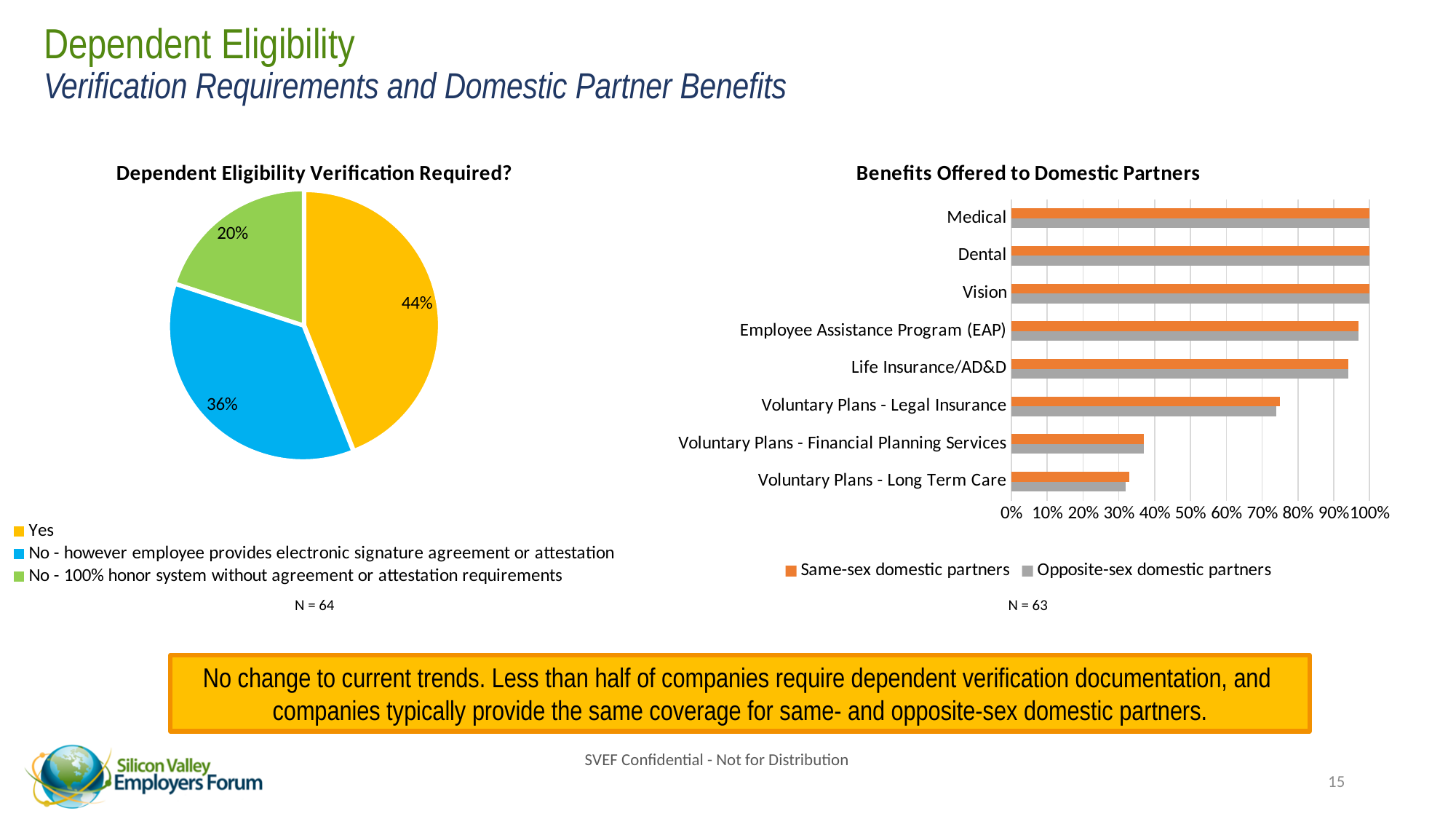
In the 'Benefits Offered to Domestic Partners' chart, is the value for 'Voluntary Plans - Long Term Care' for same-sex domestic partners greater or less than 50%? less In the 'Benefits Offered to Domestic Partners' chart, which is larger for same-sex domestic partners: 'Life Insurance/AD&D' or 'Voluntary Plans - Legal Insurance'? Life Insurance/AD&D What kind of chart is 'Benefits Offered to Domestic Partners'? Bar chart In the 'Dependent Eligibility Verification Required?' chart, what share answered 'No - however employee provides electronic signature agreement or attestation'? 36% In the 'Dependent Eligibility Verification Required?' chart, what share of respondents answered 'Yes'? 44% In the 'Dependent Eligibility Verification Required?' chart, what share answered 'No - 100% honor system without agreement or attestation requirements'? 20% In the 'Dependent Eligibility Verification Required?' chart, which response has the smallest slice? No - 100% honor system without agreement or attestation requirements What kind of chart is 'Dependent Eligibility Verification Required?'? Pie chart In the 'Dependent Eligibility Verification Required?' chart, what is the difference between the 'Yes' share and the 'No - however employee provides electronic signature agreement or attestation' share? 8% How many benefit categories are shown in the 'Benefits Offered to Domestic Partners' chart? 8 In the 'Dependent Eligibility Verification Required?' chart, which response has the largest slice? Yes How many series does the legend of the 'Benefits Offered to Domestic Partners' chart list? 2